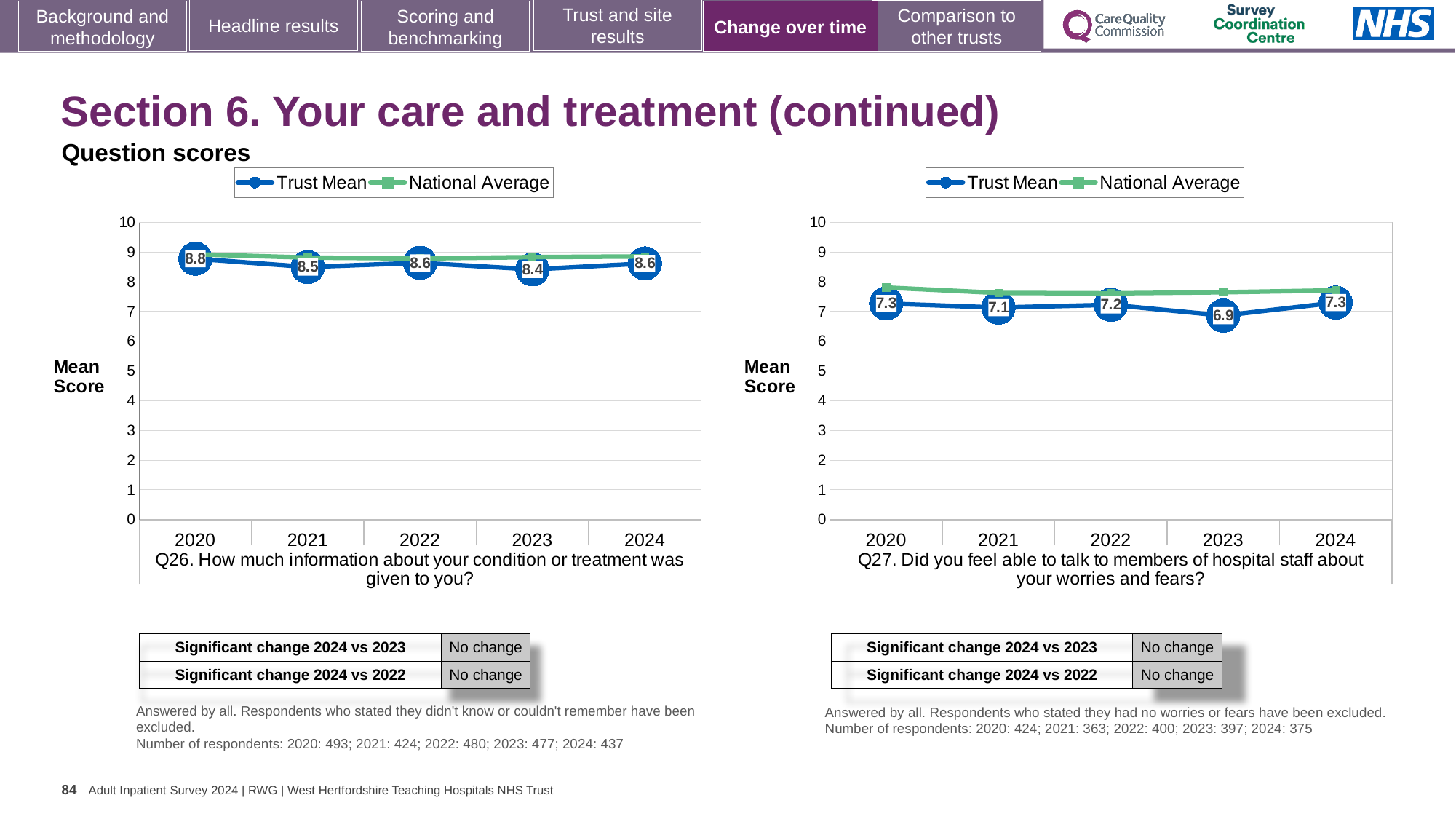
In the Q26 chart, what is the Trust Mean score for 2020? 8.8 In the Q26 chart, what is the Trust Mean score for 2023? 8.4 What type of chart is used for Q26? Line chart In the Q27 chart, what is the Trust Mean score for 2023? 6.9 In the Q26 chart, which year has the lowest Trust Mean score? 2023 In the Q26 chart, how many years are plotted on the x axis? 5 How many series does the legend of the Q27 chart list? 2 In the Q26 chart, what is the difference between the Trust Mean scores for 2020 and 2023? 0.4 In the Q27 chart, what is the difference between the Trust Mean scores for 2024 and 2023? 0.4 In the Q27 chart, what is the Trust Mean score for 2021? 7.1 In the Q27 chart, which year has the lowest Trust Mean score? 2023 In the Q27 chart, is the Trust Mean score for 2022 greater or less than 7.1? greater